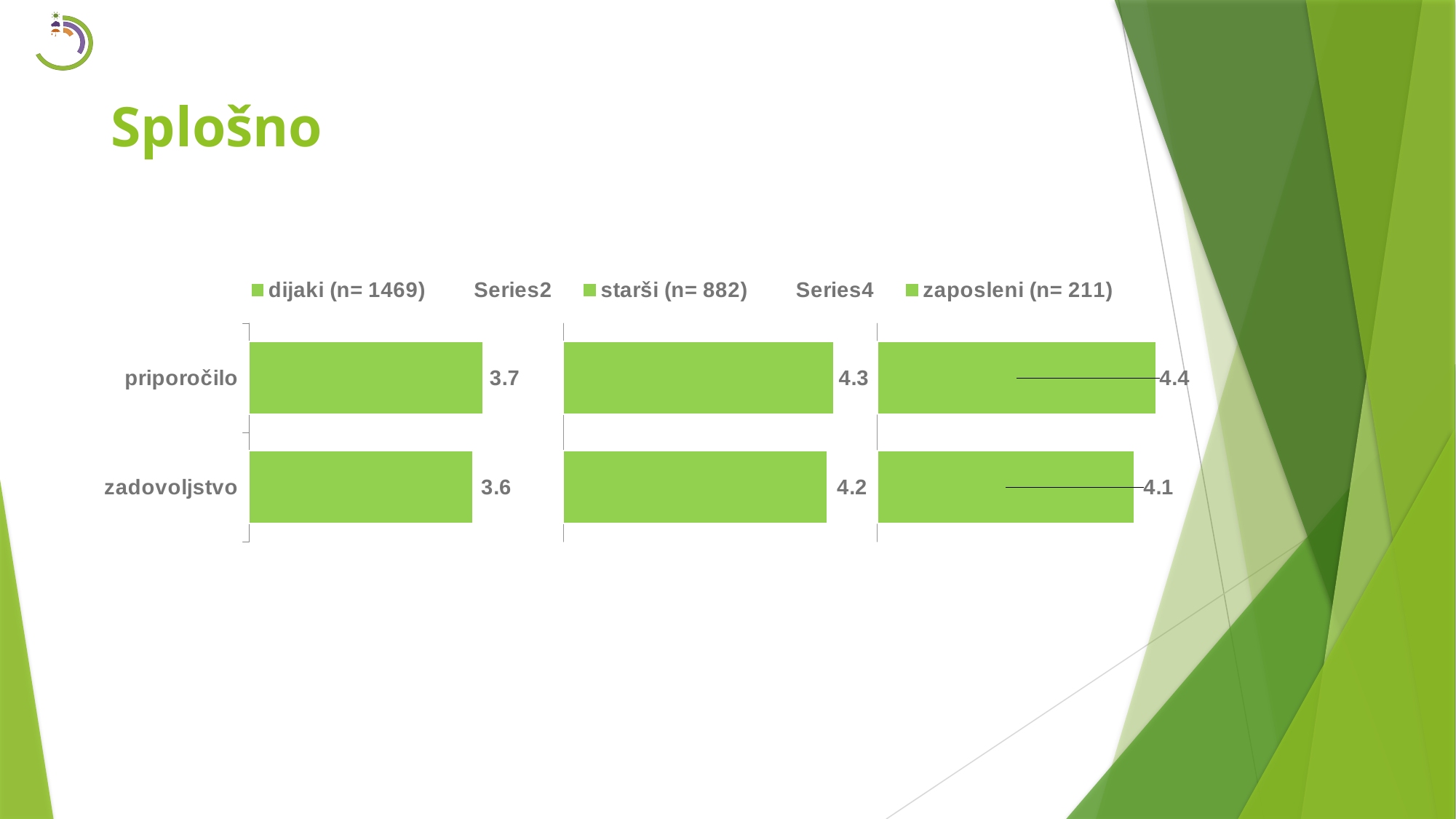
What kind of chart is shown on the slide? bar chart What is the value for zaposleni (n= 211) for priporočilo? 4.4 Which is larger for zadovoljstvo: the starši (n= 882) value or the zaposleni (n= 211) value? starši (n= 882) How many categories are shown on the vertical axis of the chart? 2 Which group has the lowest value for zadovoljstvo? dijaki (n= 1469) What is the difference between the zaposleni (n= 211) value for priporočilo and for zadovoljstvo? 0.3 What is the difference between the starši (n= 882) and dijaki (n= 1469) values for priporočilo? 0.6 What is the value for dijaki (n= 1469) for priporočilo? 3.7 What is the title of the slide containing the chart? Splošno What is the value for dijaki (n= 1469) for zadovoljstvo? 3.6 Which group has the highest value for priporočilo? zaposleni (n= 211) What is the value for starši (n= 882) for zadovoljstvo? 4.2